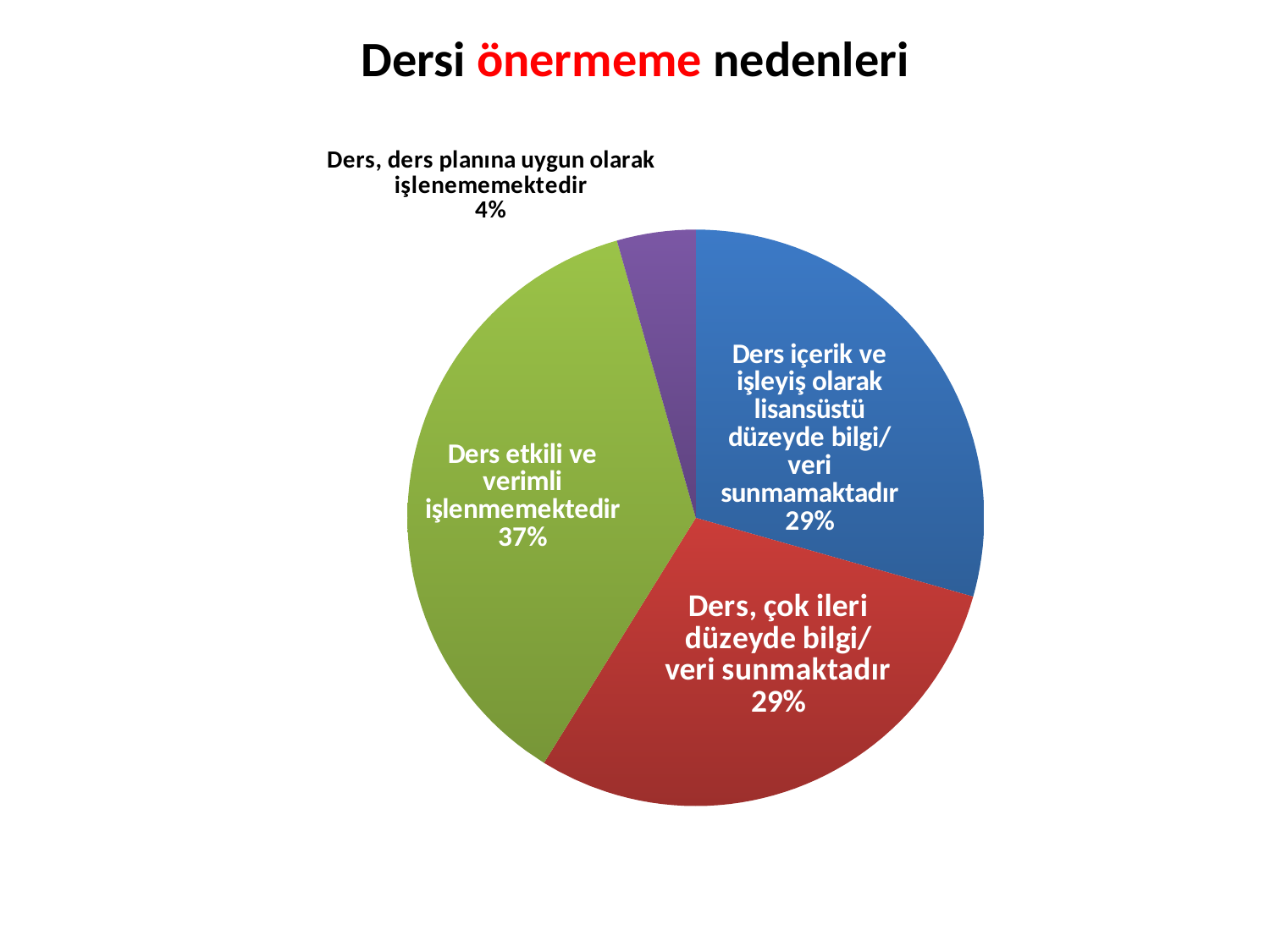
What is the difference in percentage points between 'Ders etkili ve verimli işlenmemektedir' and 'Ders, çok ileri düzeyde bilgi/veri sunmaktadır'? 8 Which is larger: the share for 'Ders etkili ve verimli işlenmemektedir' or the share for 'Ders, ders planına uygun olarak işlenememektedir'? Ders etkili ve verimli işlenmemektedir What share of the pie is 'Ders, çok ileri düzeyde bilgi/veri sunmaktadır'? 29% What share of the pie is 'Ders etkili ve verimli işlenmemektedir'? 37% Which category has the smallest share of the pie? Ders, ders planına uygun olarak işlenememektedir How many slices does the pie chart have? 4 What colour is the slice for 'Ders etkili ve verimli işlenmemektedir'? green What kind of chart is shown on the slide? pie chart What is the title of the chart? Dersi önermeme nedenleri What share of the pie is 'Ders içerik ve işleyiş olarak lisansüstü düzeyde bilgi/veri sunmamaktadır'? 29% Which category has the largest share of the pie? Ders etkili ve verimli işlenmemektedir